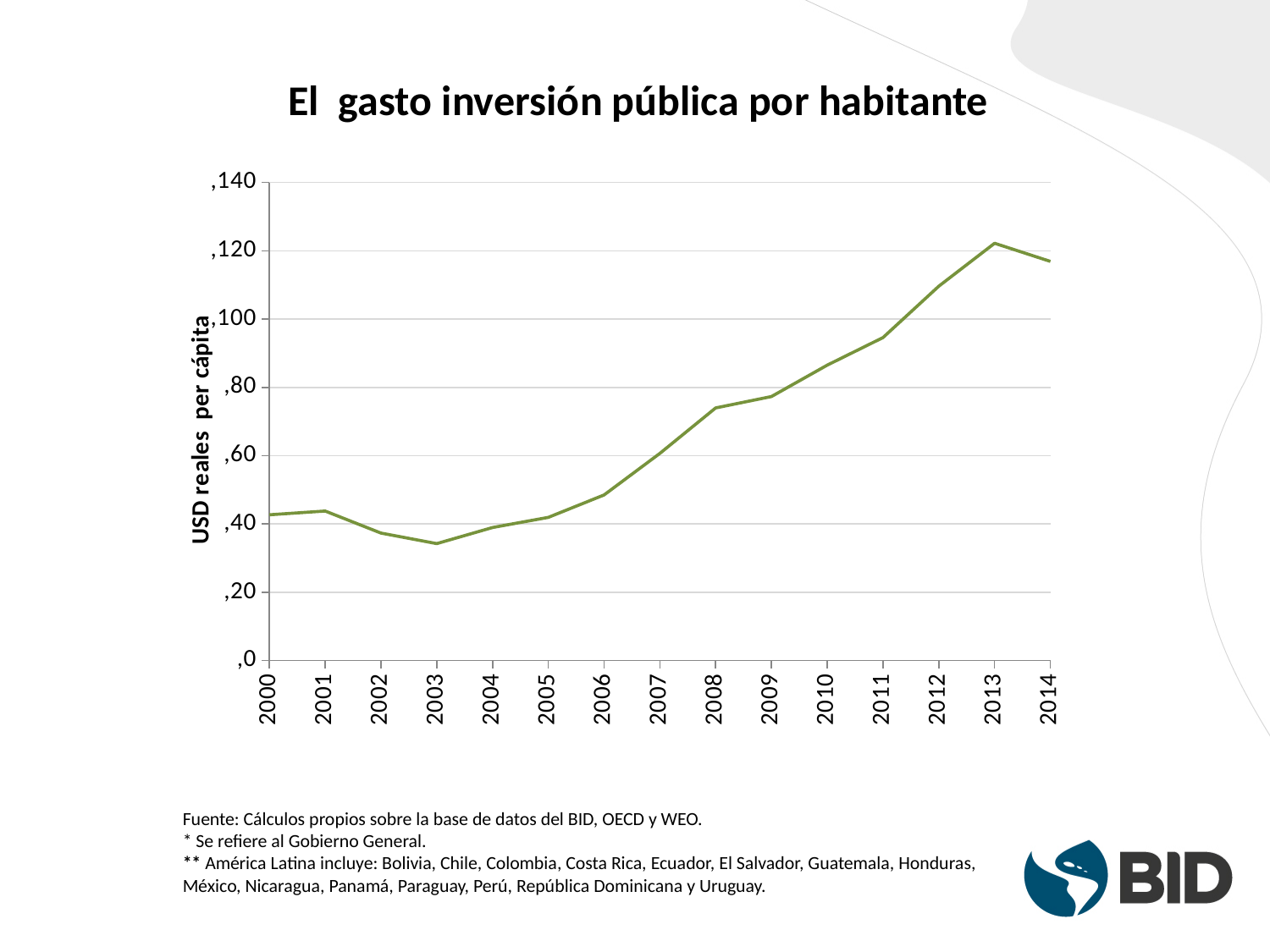
How many years are plotted along the x axis of the chart? 15 Overall, does the line rise or fall from 2000 to 2014? rise Is the value for 2003 greater or less than 40? less What is the label on the vertical axis of the chart? USD reales per cápita What kind of chart is shown on the slide? line chart In which year does the line reach its lowest value? 2003 What is the title of the chart? El gasto inversión pública por habitante In which year does the line reach its highest value? 2013 Is the value for 2013 greater or less than 120? greater Is the value for 2008 greater or less than 60? greater Which year has the larger value, 2006 or 2010? 2010